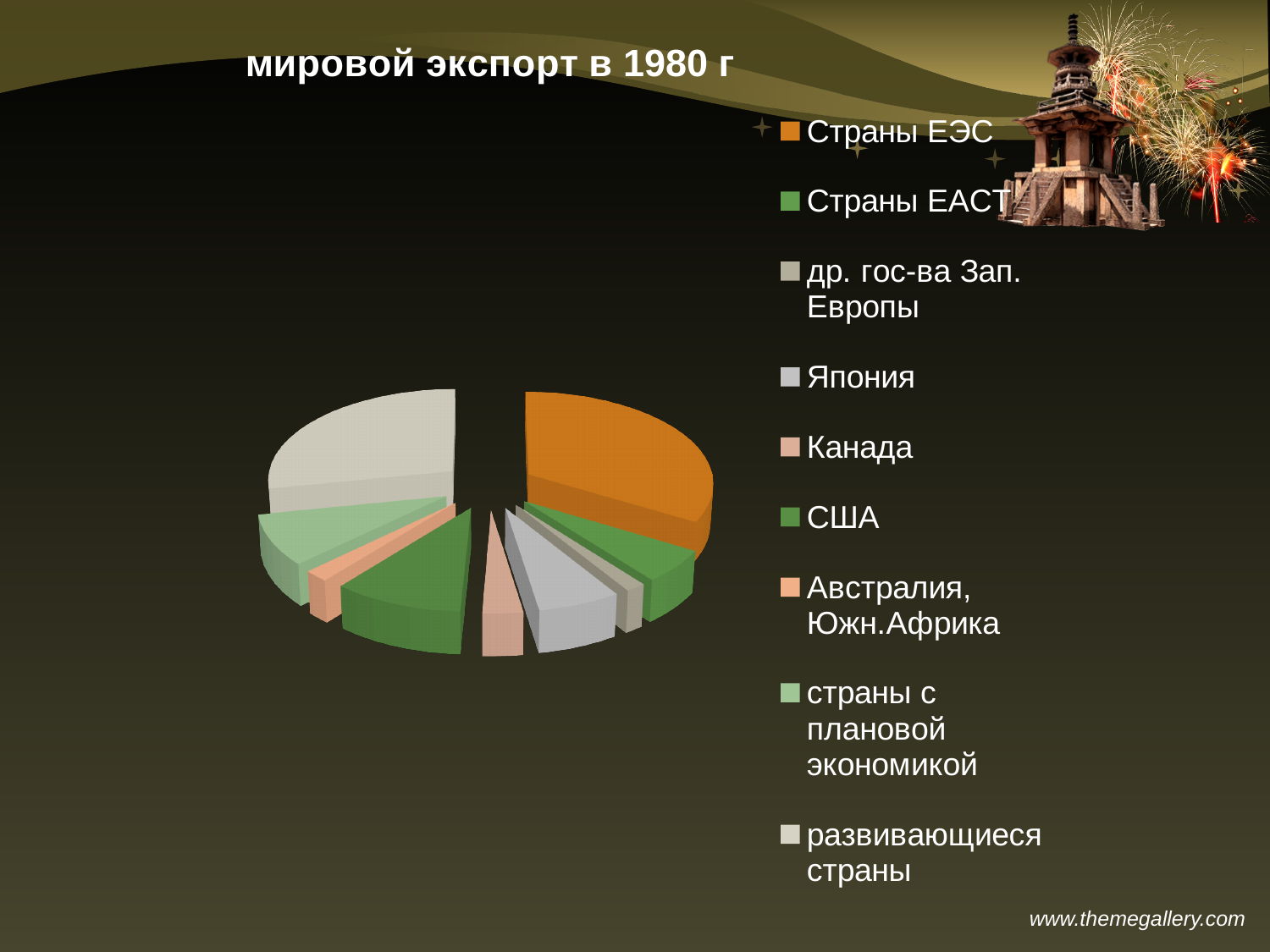
Which slice is larger, страны с плановой экономикой or Австралия, Южн.Африка? страны с плановой экономикой Which slice is larger, Страны ЕЭС or Страны ЕАСТ? Страны ЕЭС How many entries does the legend list? 9 What is the title of the chart? мировой экспорт в 1980 г Which slice is larger, Япония or Канада? Япония Which colour represents Страны ЕЭС in the pie chart? orange What kind of chart is shown on the slide? pie chart How many categories (slices) does the pie chart have? 9